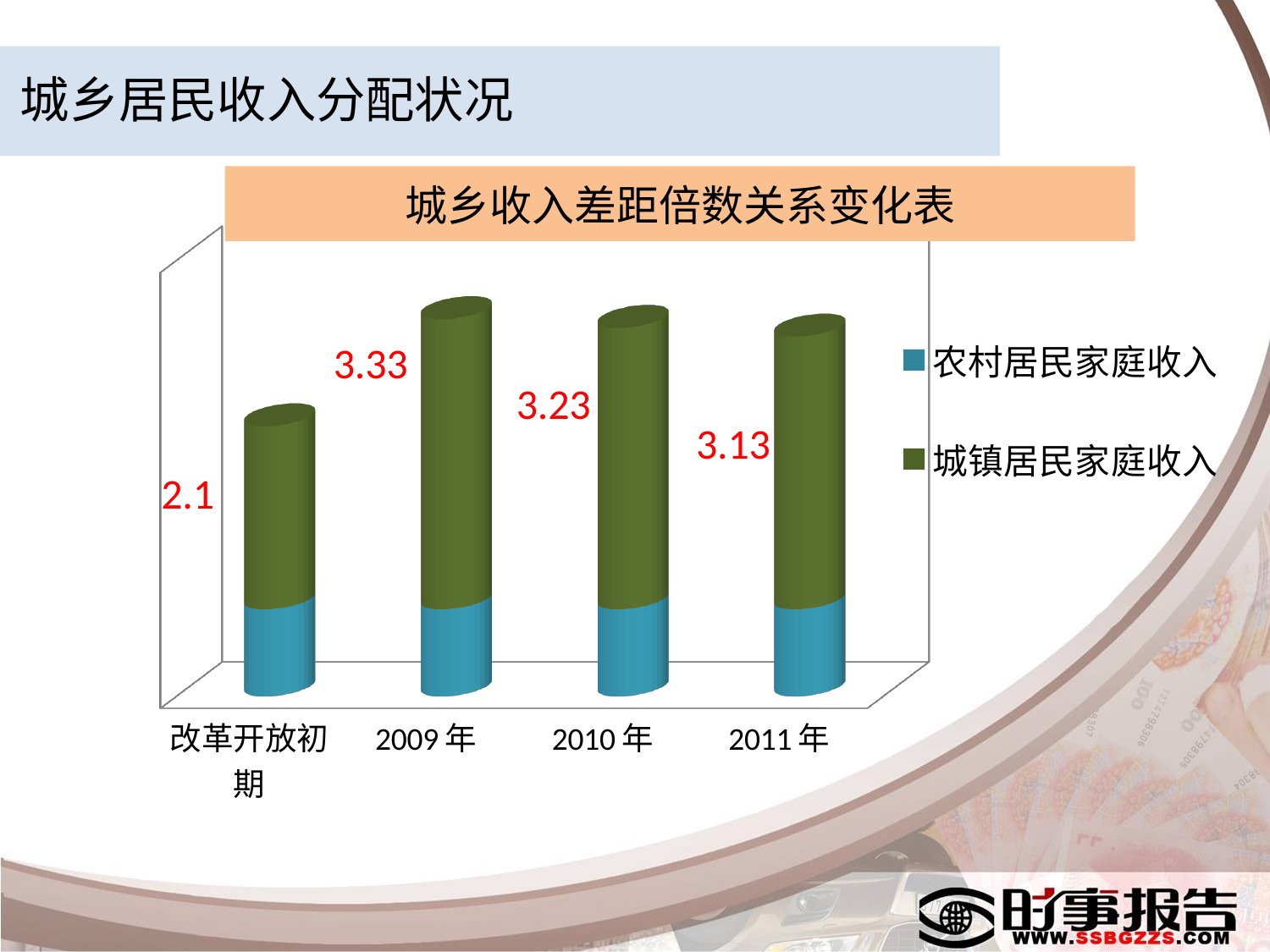
What kind of chart is shown on the slide? bar chart Which category has the highest printed number? 2009年 What number is printed next to the bar for 改革开放初期? 2.1 Do the printed numbers rise or fall from 2009年 to 2011年? fall Which category has the lowest printed number? 改革开放初期 What number is printed next to the bar for 2011年? 3.13 How many categories are shown along the x axis of the chart? 4 What number is printed next to the bar for 2009年? 3.33 What is the title of the chart? 城乡收入差距倍数关系变化表 What is the difference between the numbers printed for 2009年 and 2011年? 0.2 Which legend entry is shown in green? 城镇居民家庭收入 How many series does the chart's legend list? 2